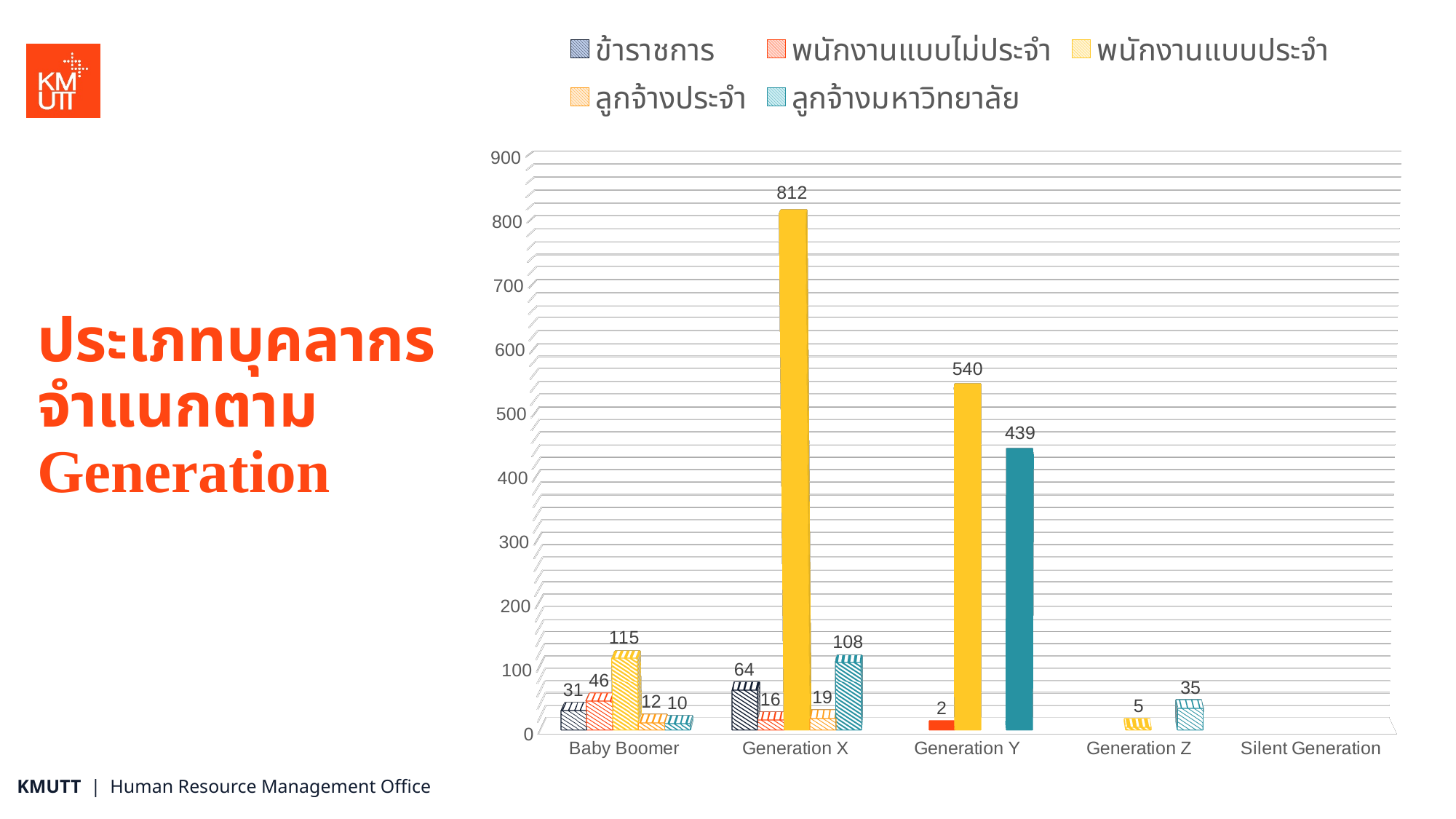
How many generation categories are shown on the x axis? 5 Which generation has the lowest value for ลูกจ้างมหาวิทยาลัย? Baby Boomer What is the difference between the ข้าราชการ values for Generation X and Baby Boomer? 33 What is the difference between the พนักงานแบบประจำ values for Generation X and Generation Y? 272 What is the value for พนักงานแบบประจำ in Generation X? 812 What kind of chart is shown on the slide? Bar chart How many series does the legend list? 5 What is the value for ลูกจ้างมหาวิทยาลัย in Generation Y? 439 What is the value for ข้าราชการ in Baby Boomer? 31 Which generation has the highest value for พนักงานแบบประจำ? Generation X What is the value for ลูกจ้างมหาวิทยาลัย in Generation Z? 35 Which is larger: พนักงานแบบประจำ in Generation Y or ลูกจ้างมหาวิทยาลัย in Generation Y? พนักงานแบบประจำ in Generation Y